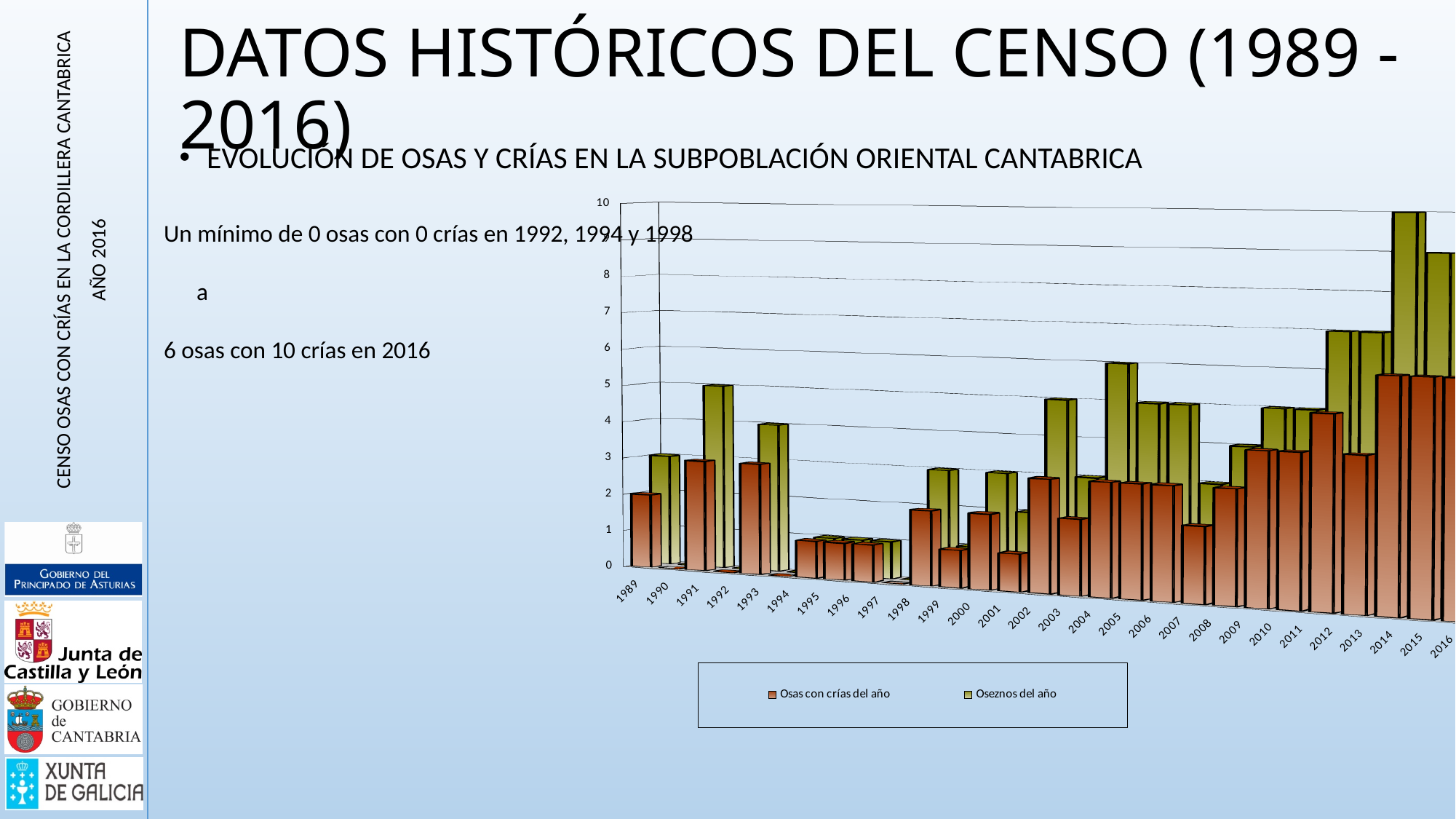
How many series does the chart legend list? 2 What are the two series named in the chart legend? Osas con crías del año; Oseznos del año What is the title of the chart? EVOLUCIÓN DE OSAS Y CRÍAS EN LA SUBPOBLACIÓN ORIENTAL CANTABRICA Is the 'Osas con crías del año' value for 1989 greater or less than 3? less What kind of chart is shown on the slide? bar chart Is the 'Oseznos del año' value for 1989 greater or less than 2? greater Is the highest value of the 'Oseznos del año' series greater or less than 8? greater Which series reaches the highest value anywhere in the chart? Oseznos del año In 1989, which series has the larger value, 'Osas con crías del año' or 'Oseznos del año'? Oseznos del año How many years are shown on the x axis of the chart? 28 Overall, do the values rise or fall from 1989 to 2016? rise According to the slide, how many crías (oseznos) were counted in 2016? 10